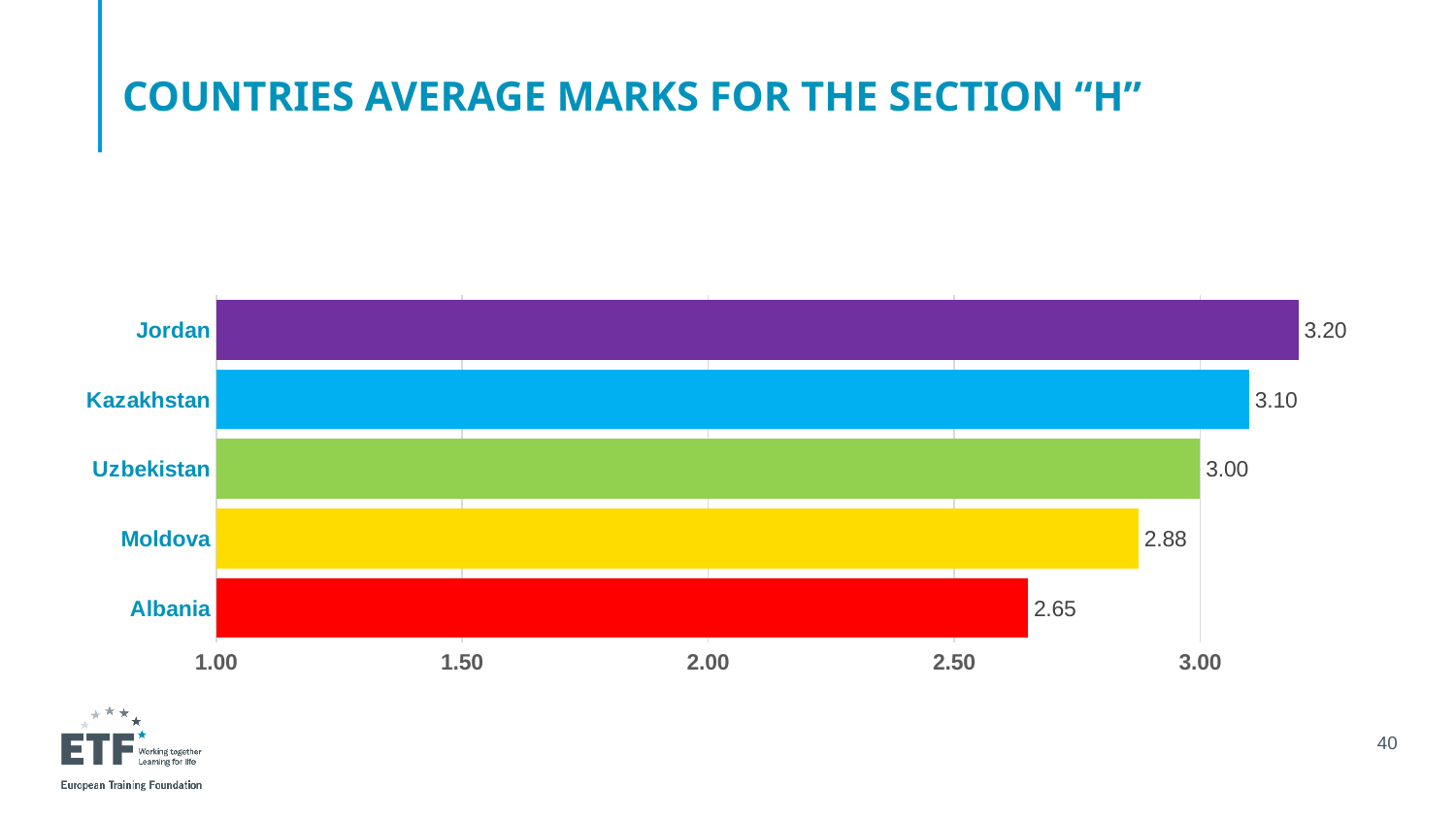
What is the average mark for Moldova? 2.88 What is the difference between the average marks of Jordan and Albania? 0.55 How many countries are shown in the chart? 5 What is the difference between the average marks of Kazakhstan and Uzbekistan? 0.10 What kind of chart is shown on the slide? Bar chart What is the title of the chart on the slide? COUNTRIES AVERAGE MARKS FOR THE SECTION "H" What is the average mark for Jordan? 3.20 Which country has the lowest average mark? Albania Which has a higher average mark, Uzbekistan or Moldova? Uzbekistan Is the value for Moldova greater or less than 3.00? less What is the average mark for Albania? 2.65 Which country has the highest average mark? Jordan